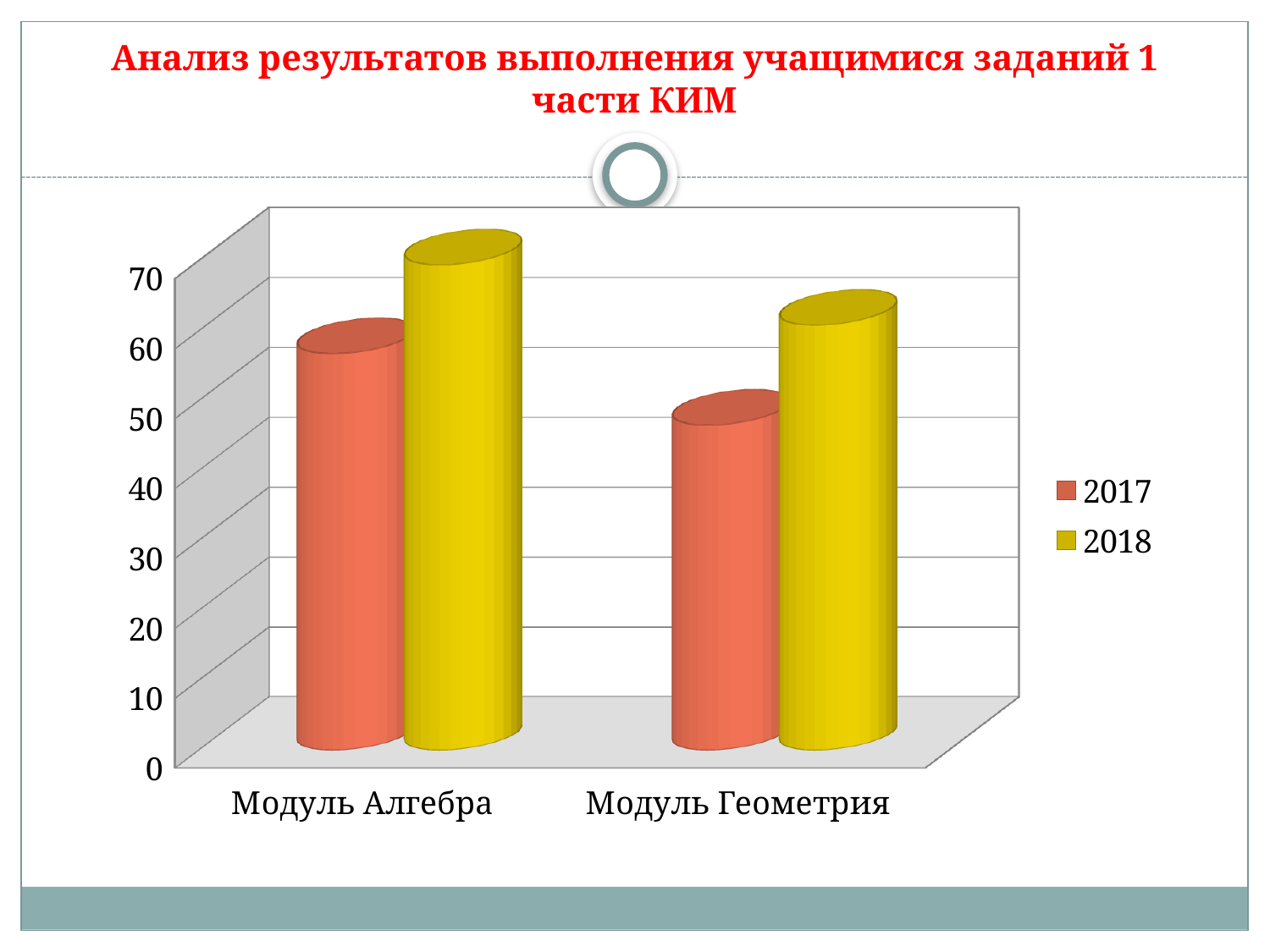
Is the 2017 value for Модуль Геометрия greater or less than 60? less Is the 2018 value for Модуль Геометрия greater or less than 50? greater What kind of chart is shown on the slide? bar chart Is the 2017 value for Модуль Алгебра greater or less than 40? greater Which bar in the chart is the lowest? Модуль Геометрия, 2017 For the 2017 series, which category has the larger value, Модуль Алгебра or Модуль Геометрия? Модуль Алгебра Which series is shown in yellow in the chart? 2018 For Модуль Алгебра, which year has the larger value, 2017 or 2018? 2018 How many series does the chart's legend list? 2 What is the title of the slide containing the chart? Анализ результатов выполнения учащимися заданий 1 части КИМ How many categories are shown on the x axis of the chart? 2